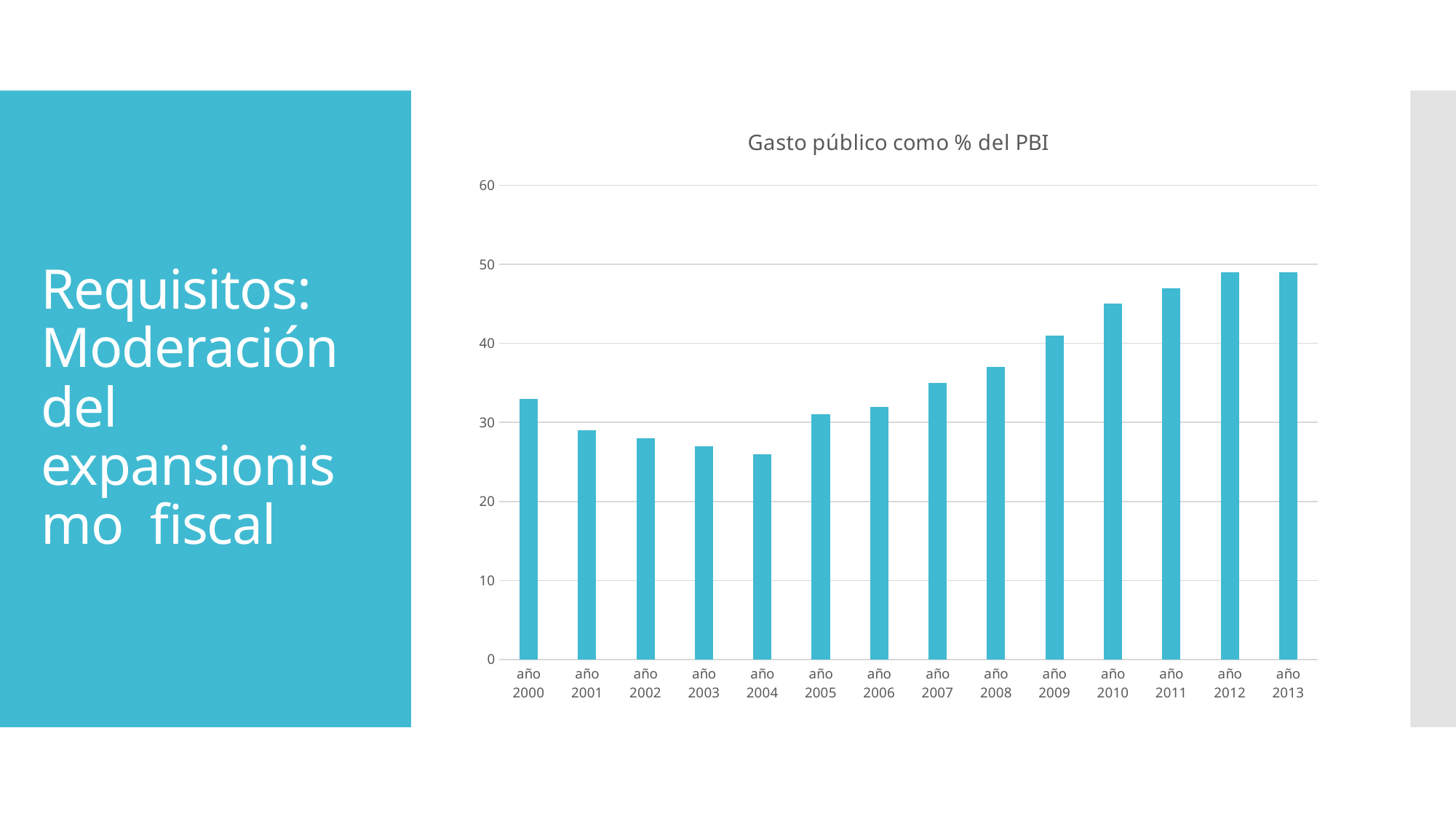
What colour are the bars in the chart? blue Is the value for año 2000 greater or less than 30? greater Which is larger, the value for año 2000 or the value for año 2004? año 2000 Is the value for año 2004 greater or less than 30? less Is the value for año 2012 greater or less than 50? less How many years (categories) are plotted in the chart? 14 Which is larger, the value for año 2010 or the value for año 2005? año 2010 Do the values generally rise or fall from año 2004 to año 2013? rise What is the title of the chart? Gasto público como % del PBI What kind of chart is shown on the slide? bar chart